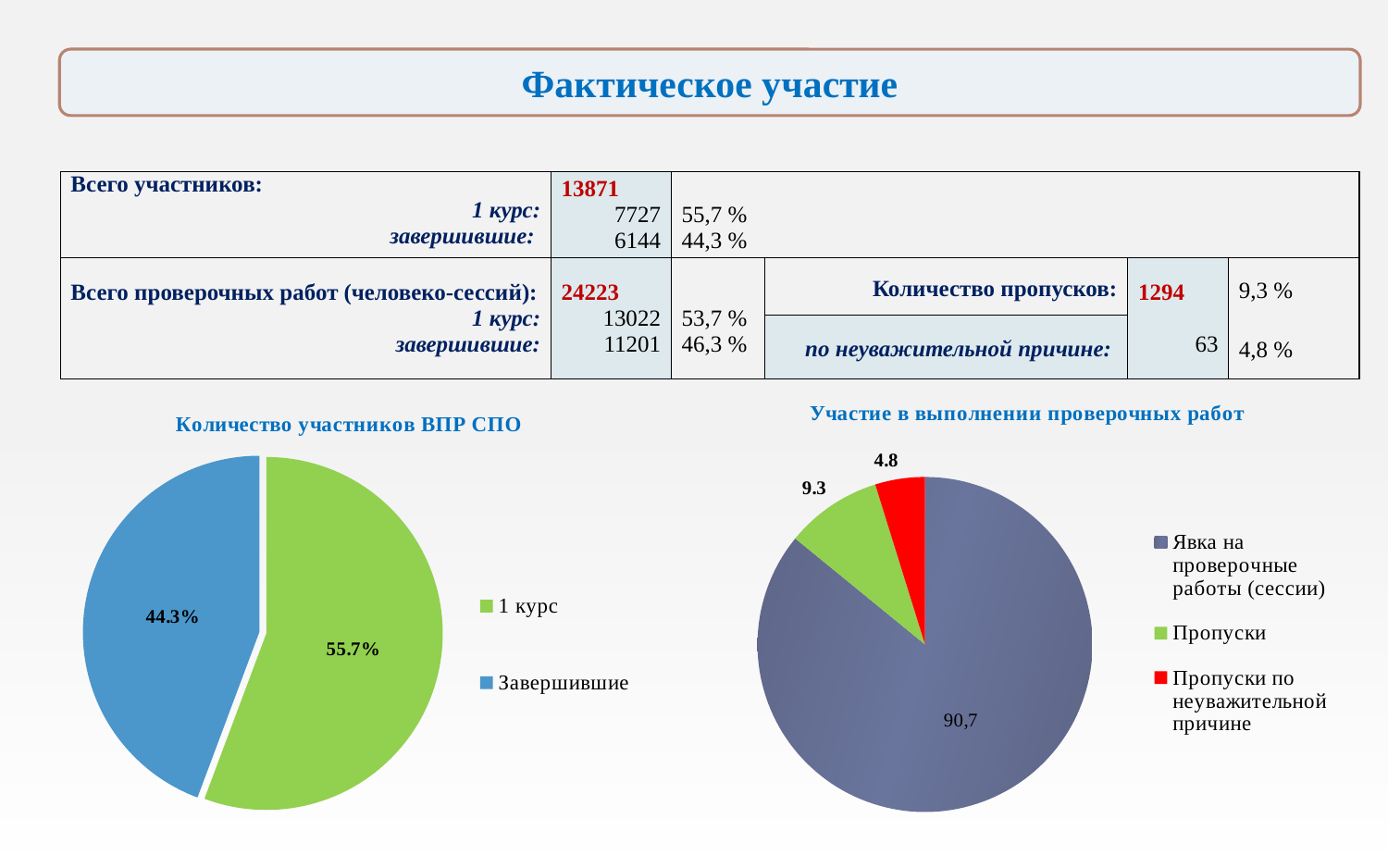
На диаграмме «Количество участников ВПР СПО» какая доля приходится на «Завершившие»? 44.3% На диаграмме «Участие в выполнении проверочных работ» какое значение у категории «Пропуски»? 9.3 На диаграмме «Количество участников ВПР СПО» какая доля приходится на «1 курс»? 55.7% На диаграмме «Участие в выполнении проверочных работ» какое значение у категории «Явка на проверочные работы (сессии)»? 90,7 На диаграмме «Участие в выполнении проверочных работ» какая категория имеет наименьшее значение? Пропуски по неуважительной причине Сколько категорий перечислено в легенде диаграммы «Участие в выполнении проверочных работ»? 3 Сколько категорий перечислено в легенде диаграммы «Количество участников ВПР СПО»? 2 На диаграмме «Количество участников ВПР СПО» какая категория имеет наибольшую долю? 1 курс На диаграмме «Количество участников ВПР СПО» на сколько процентных пунктов доля «1 курс» больше доли «Завершившие»? 11.4 Какого типа диаграмма «Количество участников ВПР СПО»? Круговая диаграмма На диаграмме «Участие в выполнении проверочных работ» какое значение у категории «Пропуски по неуважительной причине»? 4.8 На диаграмме «Участие в выполнении проверочных работ» каким цветом показана категория «Пропуски по неуважительной причине»? Красным